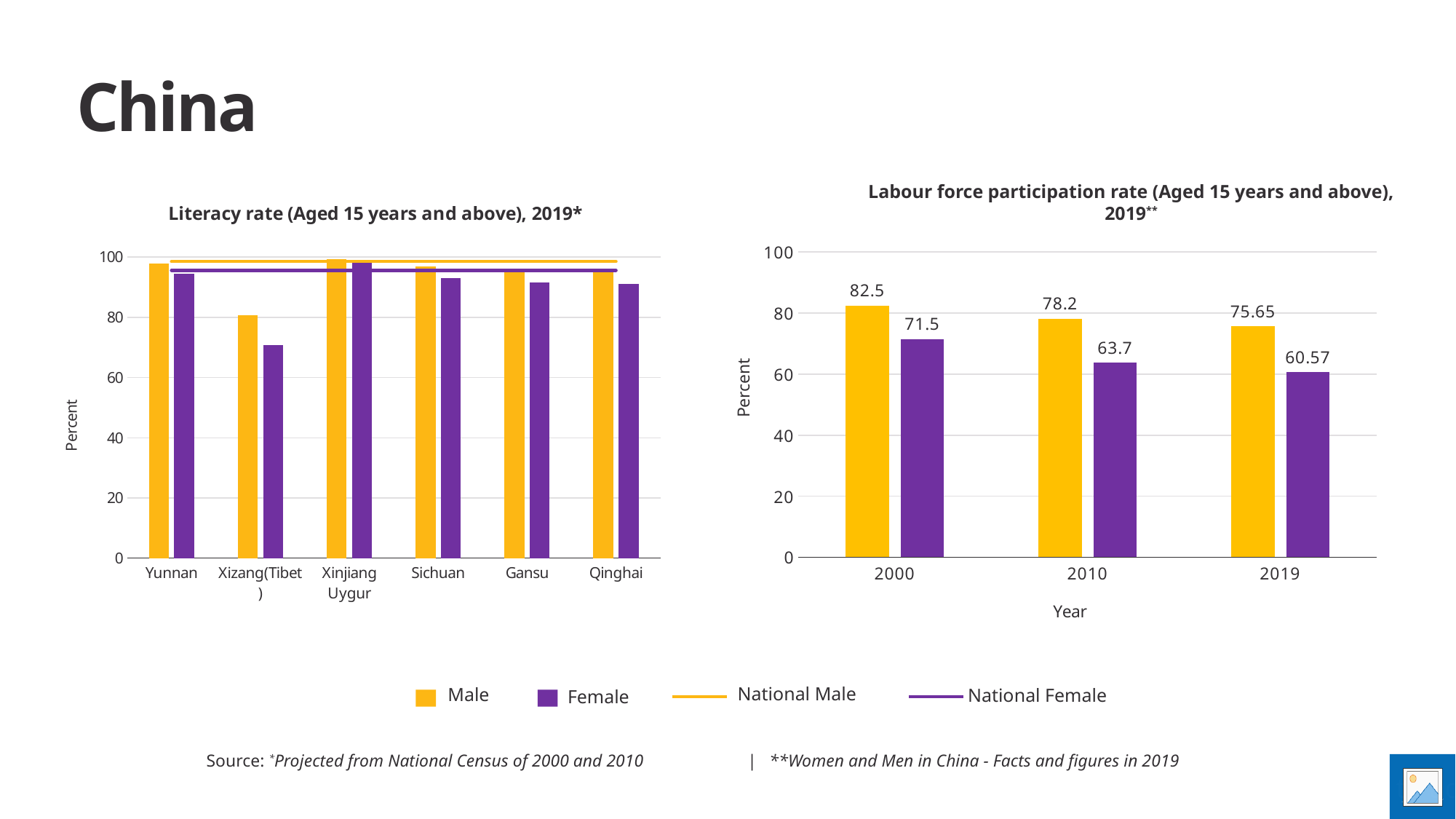
In the Labour force participation rate chart, which year has the lowest Female value? 2019 In the Labour force participation rate chart, what is the difference between the Male values for 2000 and 2019? 6.85 In the Literacy rate chart, how many provinces are shown on the x axis? 6 In the Labour force participation rate chart, what is the difference between the Male and Female values in 2000? 11 In the Labour force participation rate chart, do the Male values rise or fall from 2000 to 2019? fall In the Labour force participation rate chart, what is the Female value for 2010? 63.7 In the Labour force participation rate chart, how many years are shown on the x axis? 3 In the Labour force participation rate chart, what is the Male value for 2000? 82.5 In the Literacy rate chart, which province has the lowest Female literacy rate? Xizang(Tibet) In the Labour force participation rate chart, what is the Female value for 2019? 60.57 What type of chart is the Literacy rate chart? combination bar and line chart In the Literacy rate chart, is the Female value for Xizang(Tibet) greater or less than 80? less